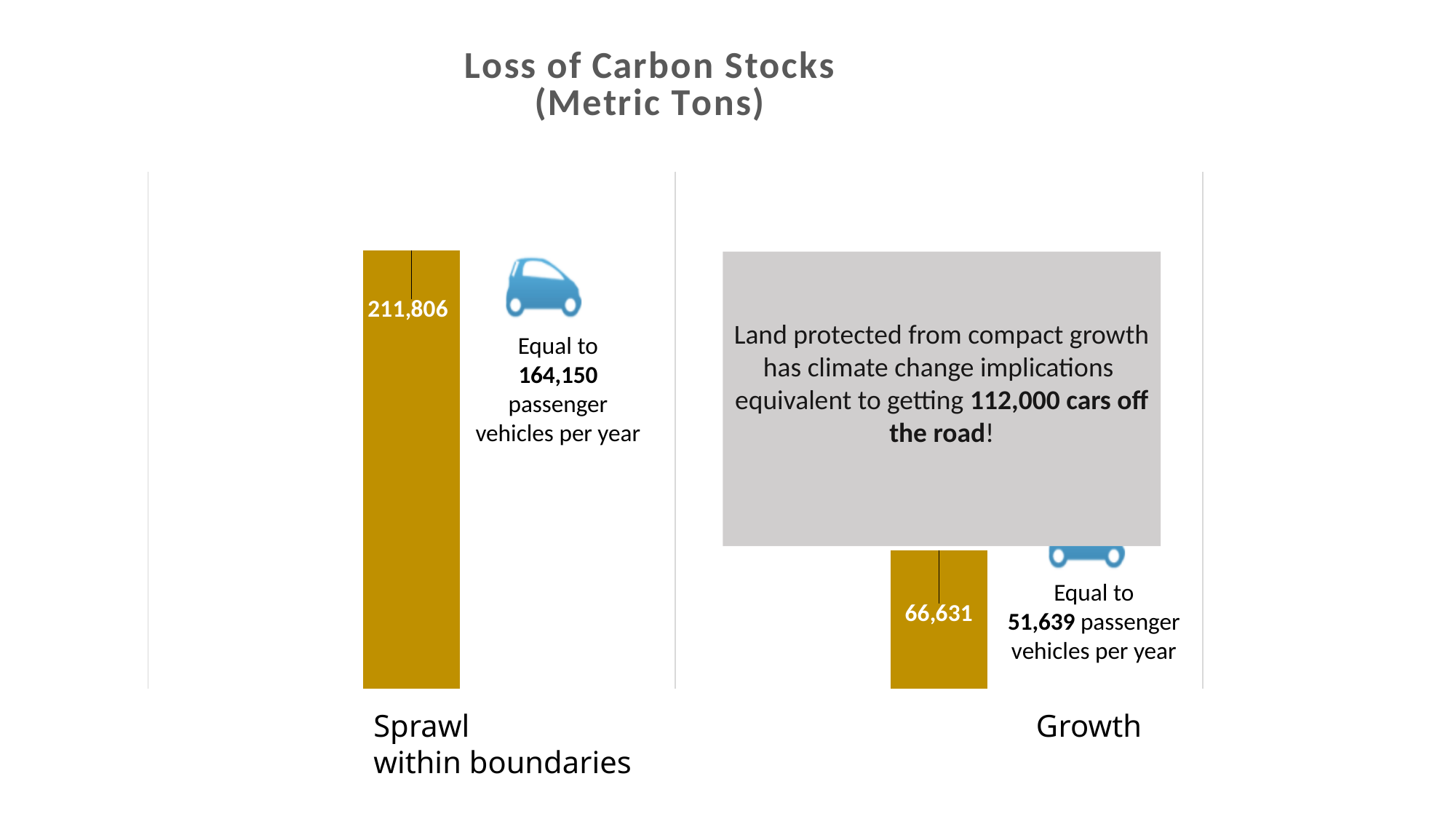
What unit is the loss of carbon stocks measured in, according to the chart title? Metric Tons Which category has the lowest loss of carbon stocks? Growth within boundaries What is the loss of carbon stocks for Sprawl? 211,806 What is the difference in loss of carbon stocks between Sprawl and Growth within boundaries? 145,175 What is the title of the chart? Loss of Carbon Stocks (Metric Tons) What kind of chart is shown on the slide? Bar chart How many categories are shown in the chart? 2 Which has a larger loss of carbon stocks, Sprawl or Growth within boundaries? Sprawl What is the total loss of carbon stocks across both categories? 278,437 What is the loss of carbon stocks for Growth within boundaries? 66,631 Which category has the highest loss of carbon stocks? Sprawl